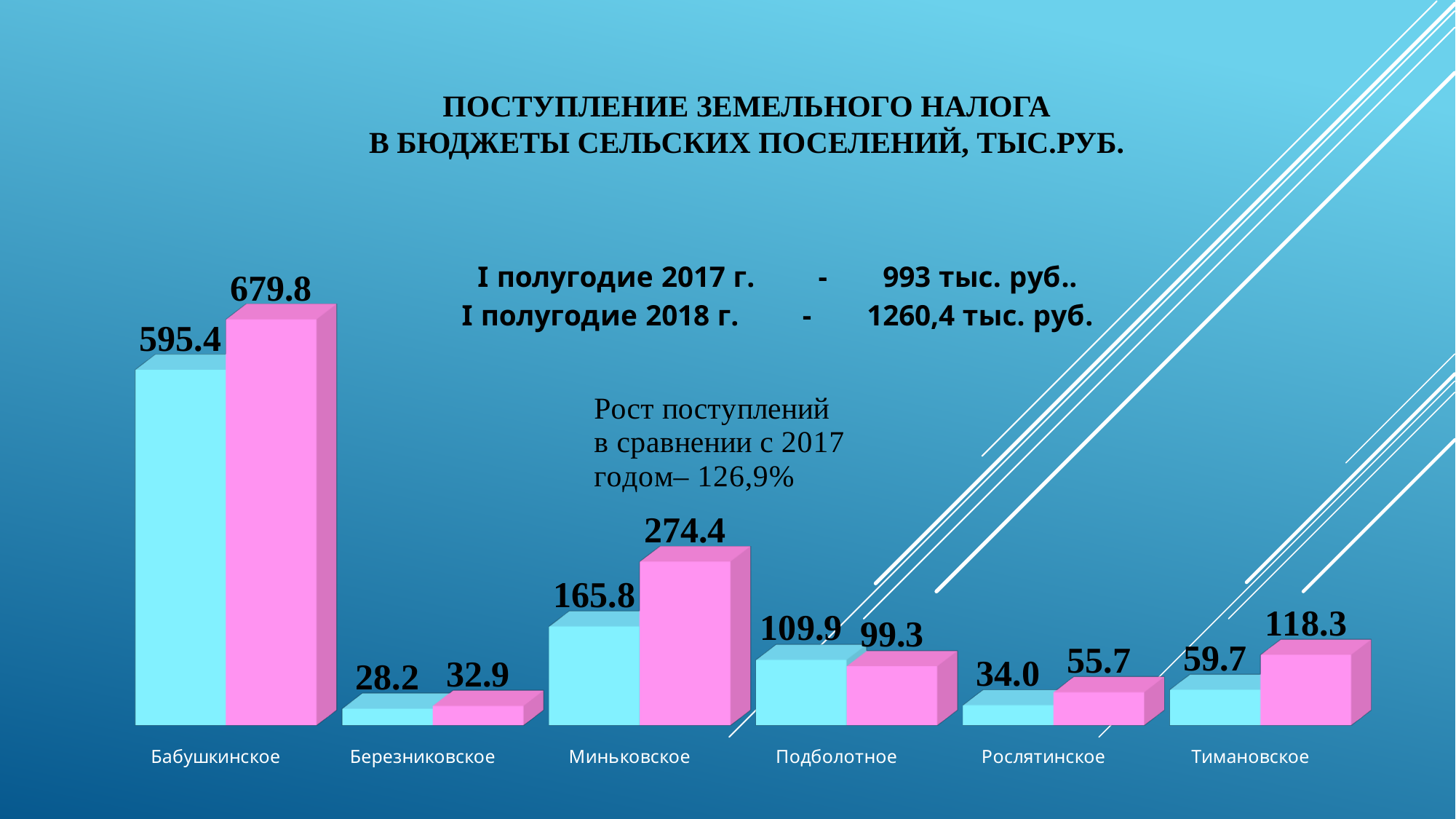
What is the difference between the pink and light blue bars for Миньковское? 108.6 What is the value of the light blue bar for Миньковское? 165.8 What is the title of the chart? ПОСТУПЛЕНИЕ ЗЕМЕЛЬНОГО НАЛОГА В БЮДЖЕТЫ СЕЛЬСКИХ ПОСЕЛЕНИЙ, ТЫС.РУБ. How many categories (settlements) are shown on the x axis of the chart? 6 Which category has the highest pink bar? Бабушкинское What is the difference between the light blue bar for Бабушкинское and the light blue bar for Подболотное? 485.5 What is the value of the light blue bar for Рослятинское? 34.0 What type of chart is shown on the slide? bar chart What is the value of the pink bar for Тимановское? 118.3 What is the value of the pink bar for Бабушкинское? 679.8 Which category has the lowest light blue bar? Березниковское For Подболотное, which bar is larger, the light blue one or the pink one? the light blue one